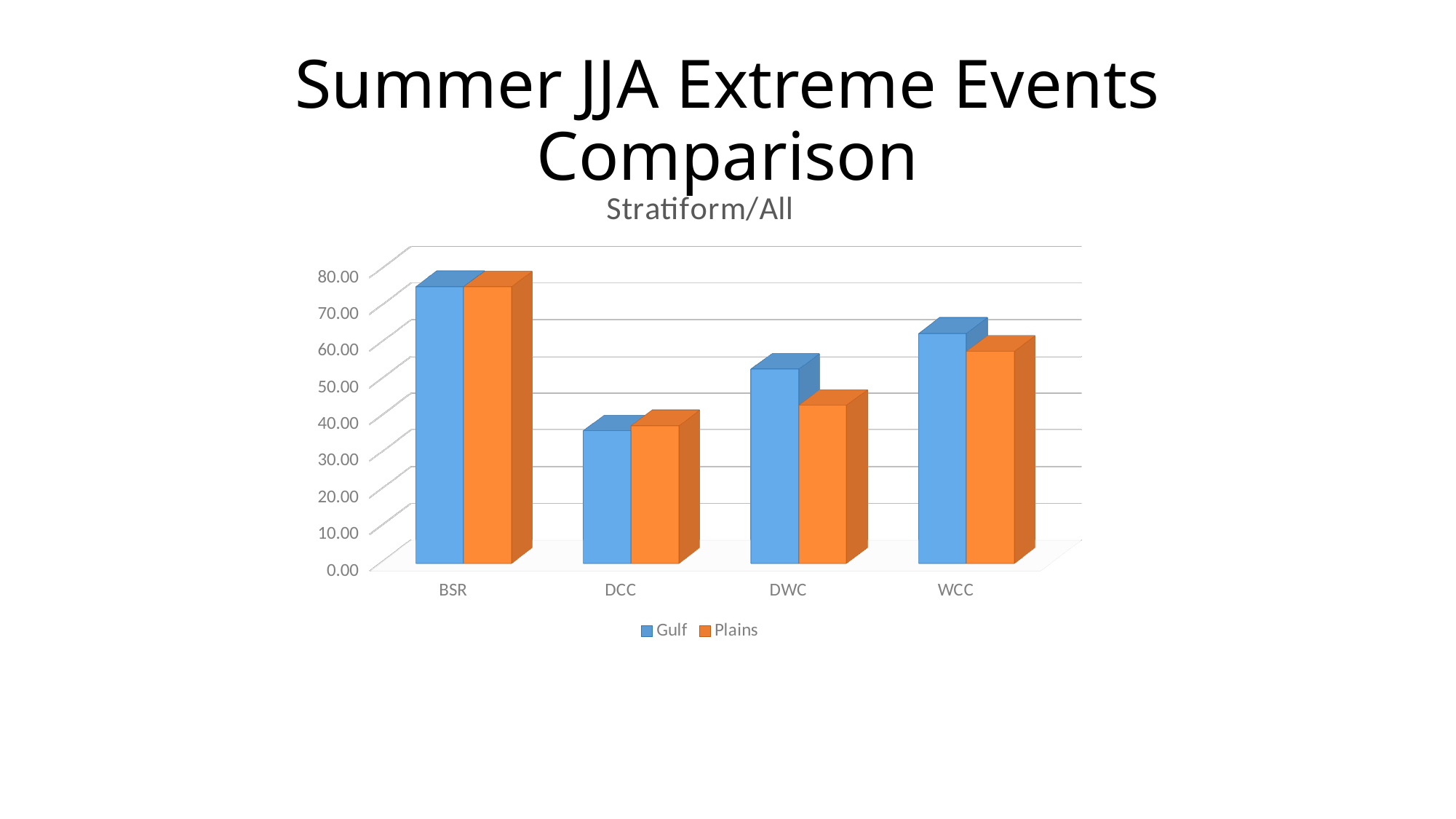
Is the Gulf value for BSR greater or less than 70.00? greater Is the Plains value for DWC greater or less than 50.00? less Which category has the lowest Plains value? DCC What kind of chart is shown on the slide? bar chart For DWC, which is larger, the Gulf value or the Plains value? Gulf Which category has the lowest Gulf value? DCC What is the title of the chart? Stratiform/All How many categories are shown on the x axis of the chart? 4 Which category has the highest Gulf value? BSR How many series does the chart legend list? 2 Which series is shown in orange in the chart? Plains Is the Gulf value for DCC greater or less than 40.00? less